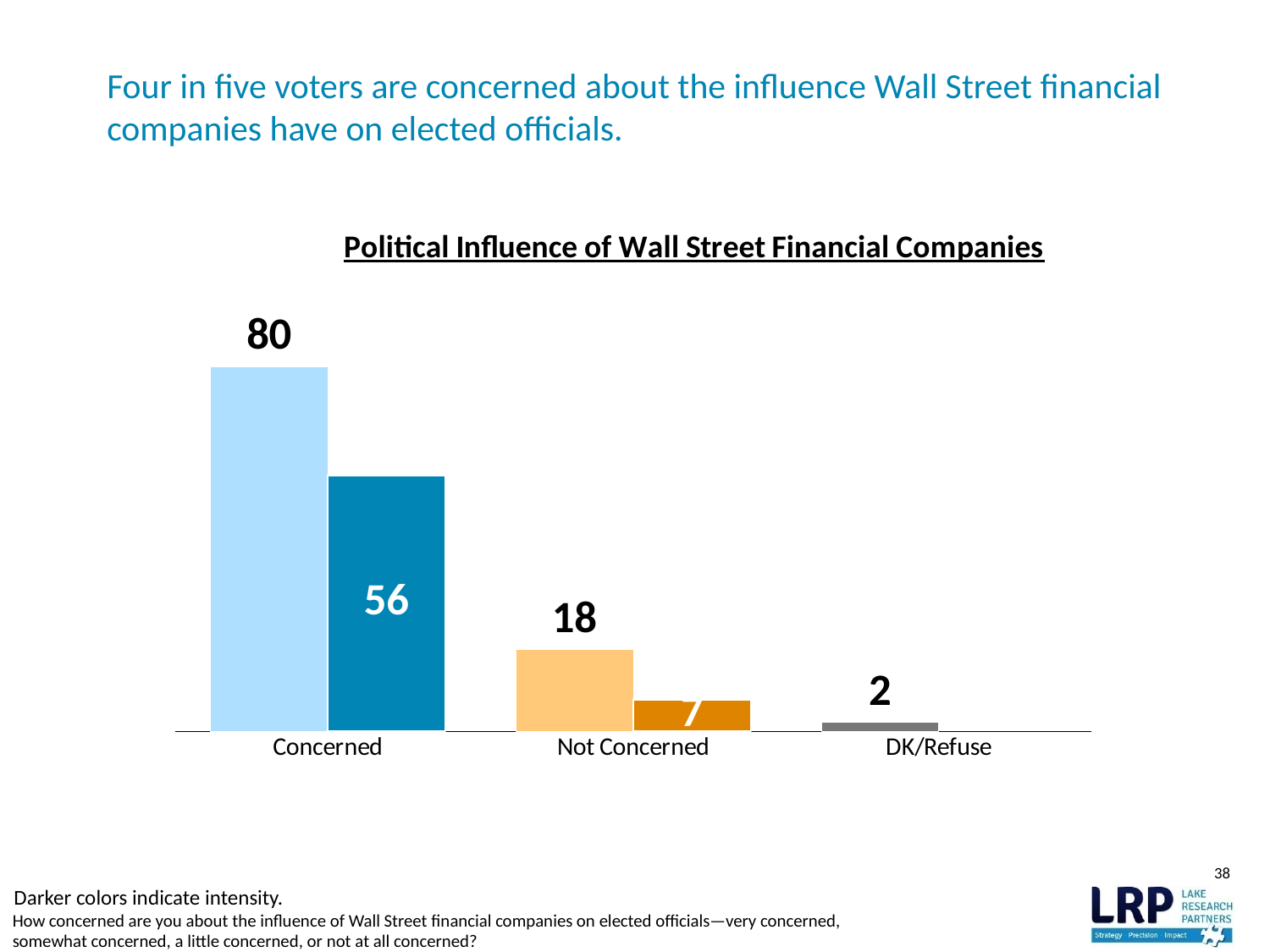
What is the value of the darker bar for Concerned? 56 What type of chart is shown on the slide? Bar chart Which is larger, the value for Not Concerned (lighter bar) or the value for DK/Refuse? Not Concerned What is the value of the darker bar for Not Concerned? 7 What is the value of the lighter bar for Not Concerned? 18 What is the value of the lighter bar for Concerned? 80 Which category has the lowest value? DK/Refuse Which category has the highest value? Concerned What is the difference between the darker bars for Concerned and Not Concerned? 49 What is the difference between the lighter bars for Concerned and Not Concerned? 62 What is the value for DK/Refuse? 2 How many categories are shown on the x axis? 3